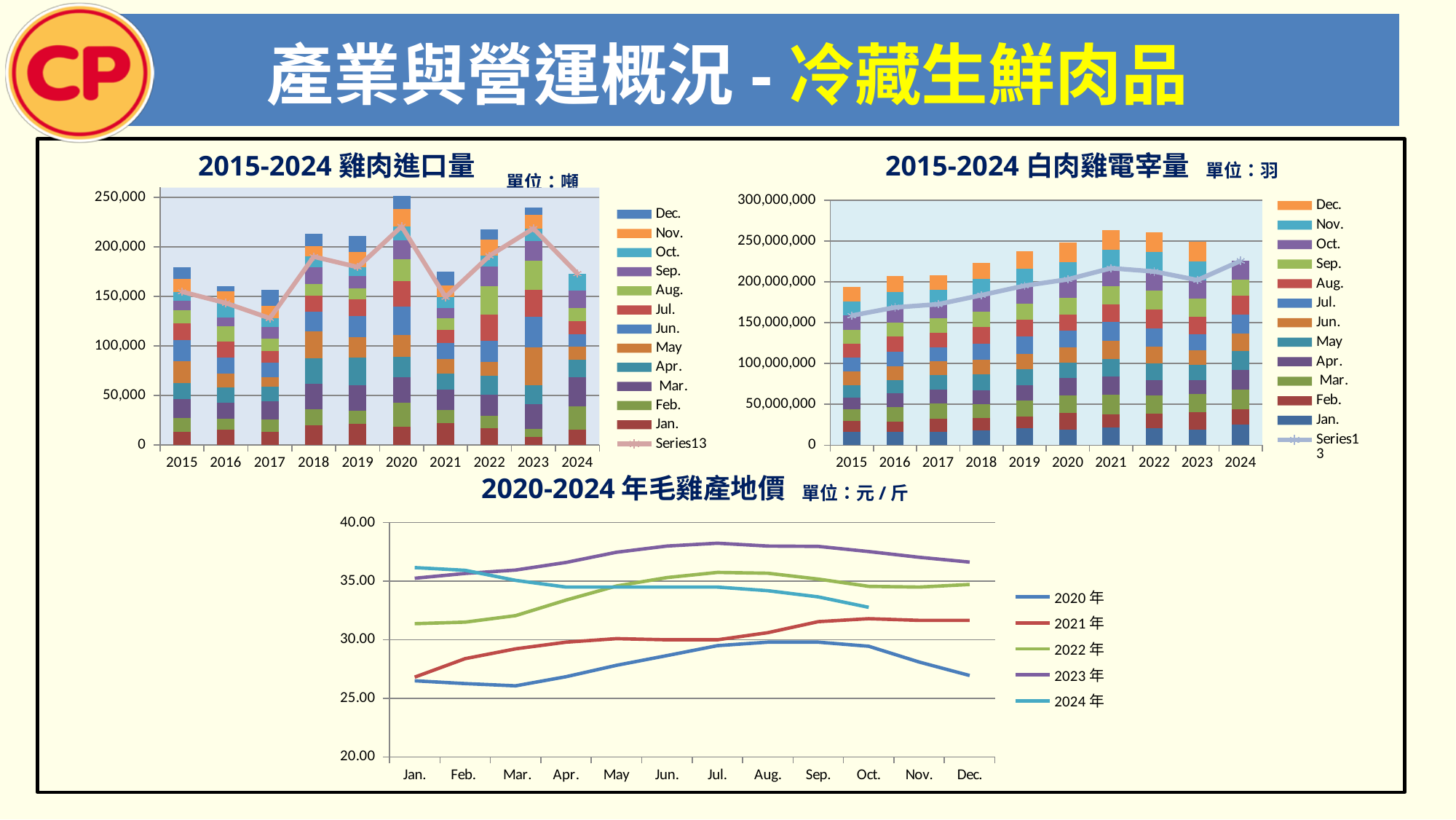
How many years are shown on the x axis of the "2015-2024 白肉雞電宰量" chart? 10 What kind of chart is the "2020-2024 年毛雞產地價" chart? line chart In the "2015-2024 雞肉進口量" chart, is the total for 2024 greater or less than 200,000? less What kind of chart is the "2015-2024 雞肉進口量" chart? combination stacked bar and line chart In the "2020-2024 年毛雞產地價" chart, which year's line is the highest across the months? 2023 年 How many series does the legend of the "2020-2024 年毛雞產地價" chart list? 5 In the "2015-2024 白肉雞電宰量" chart, is the total for 2021 greater or less than 250,000,000? greater In the "2015-2024 雞肉進口量" chart, is the total for 2020 greater or less than 200,000? greater In the "2015-2024 白肉雞電宰量" chart, which year has the lowest total? 2015 What unit is stated for the "2020-2024 年毛雞產地價" chart? 元 / 斤 In the "2015-2024 雞肉進口量" chart, which year has the highest total? 2020